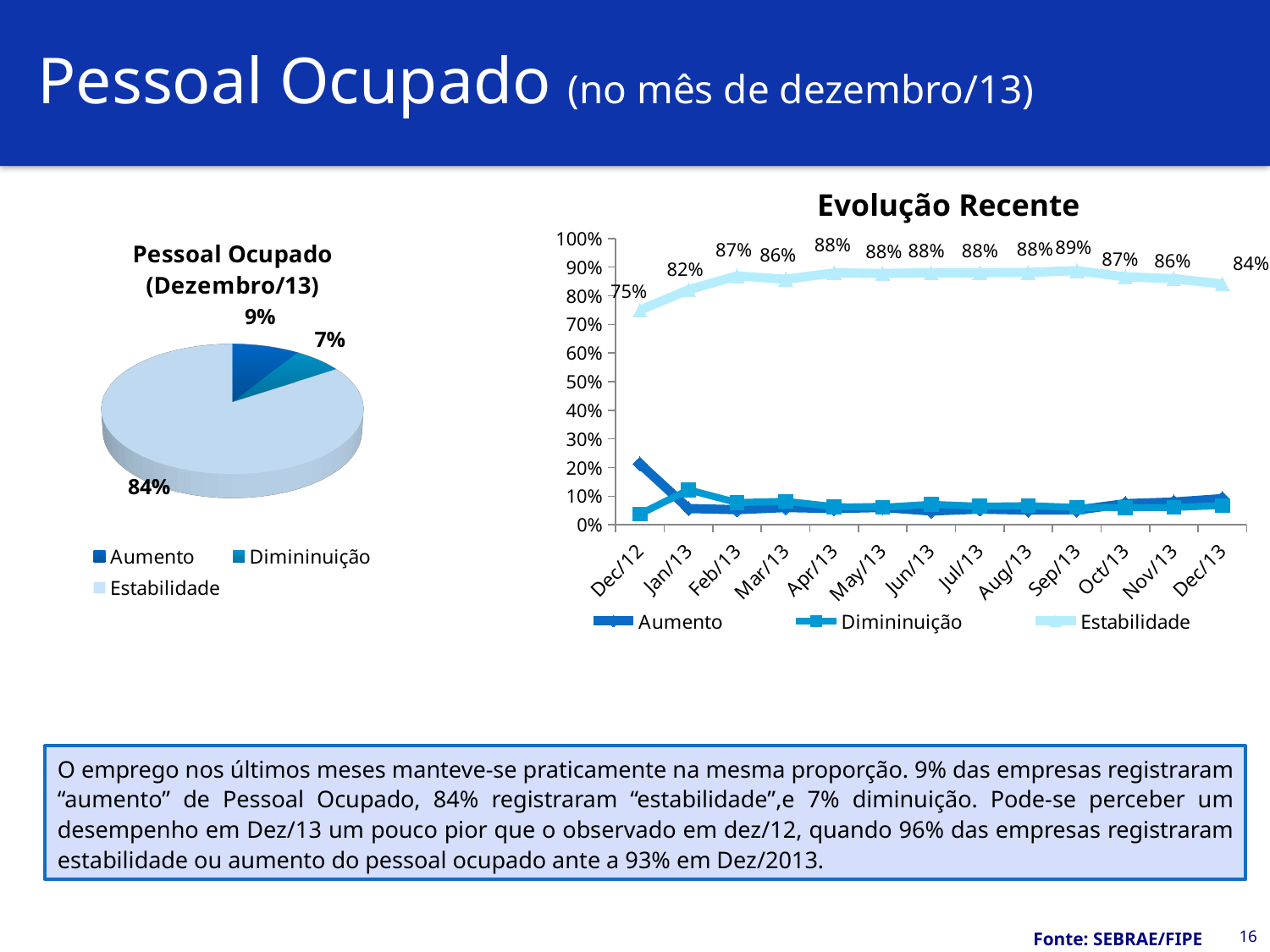
In the 'Evolução Recente' chart, what is the difference between the Estabilidade values for Sep/13 and Dec/13? 5% What kind of chart is the one on the left titled 'Pessoal Ocupado (Dezembro/13)'? Pie chart In the pie chart 'Pessoal Ocupado (Dezembro/13)', what share is labelled for Estabilidade? 84% In the 'Evolução Recente' chart, is the Aumento value for Dec/12 greater or less than 10%? greater In the pie chart 'Pessoal Ocupado (Dezembro/13)', which category has the smallest slice? Dimininuição In the 'Evolução Recente' chart, what is the Estabilidade value for Dec/12? 75% In the 'Evolução Recente' chart, in which month is the Estabilidade value lowest? Dec/12 How many months are plotted on the x axis of the 'Evolução Recente' chart? 13 In the 'Evolução Recente' chart, in which month is the Estabilidade value highest? Sep/13 In the 'Evolução Recente' chart, what is the Estabilidade value for Sep/13? 89% How many series does the legend of the 'Evolução Recente' chart list? 3 In the pie chart 'Pessoal Ocupado (Dezembro/13)', what is the value for Aumento? 9%